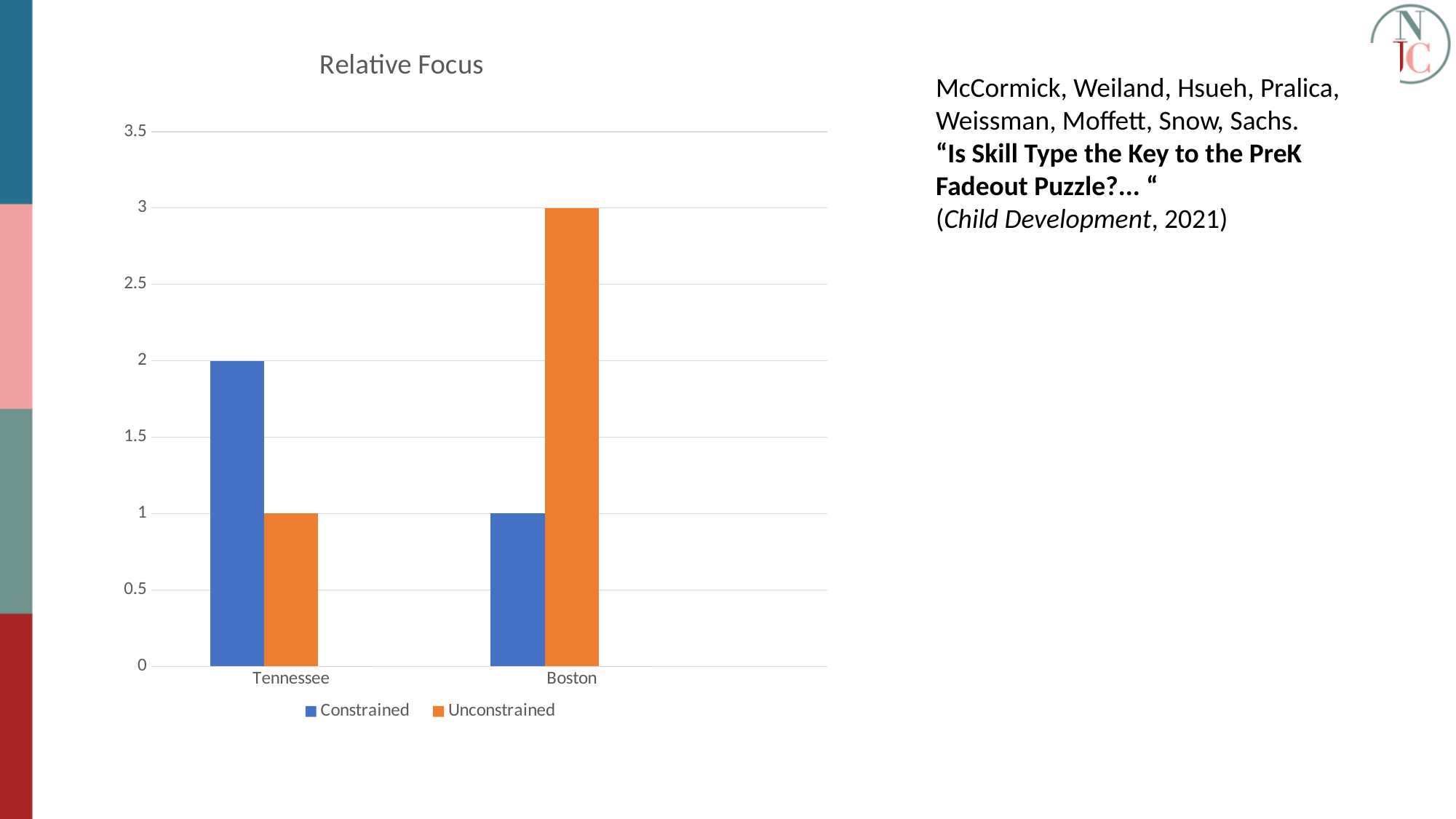
Which category has the highest Unconstrained value? Boston Which category has the lowest Constrained value? Boston What is the Constrained value for Tennessee? 2 What is the Unconstrained value for Boston? 3 What is the difference between the Unconstrained value for Boston and the Constrained value for Boston? 2 Which is larger for Tennessee, the Constrained value or the Unconstrained value? Constrained How many categories are shown on the x axis of the chart? 2 What is the title of the chart? Relative Focus What kind of chart is shown on the slide? Bar chart What is the Unconstrained value for Tennessee? 1 How many series does the chart legend list? 2 What is the Constrained value for Boston? 1